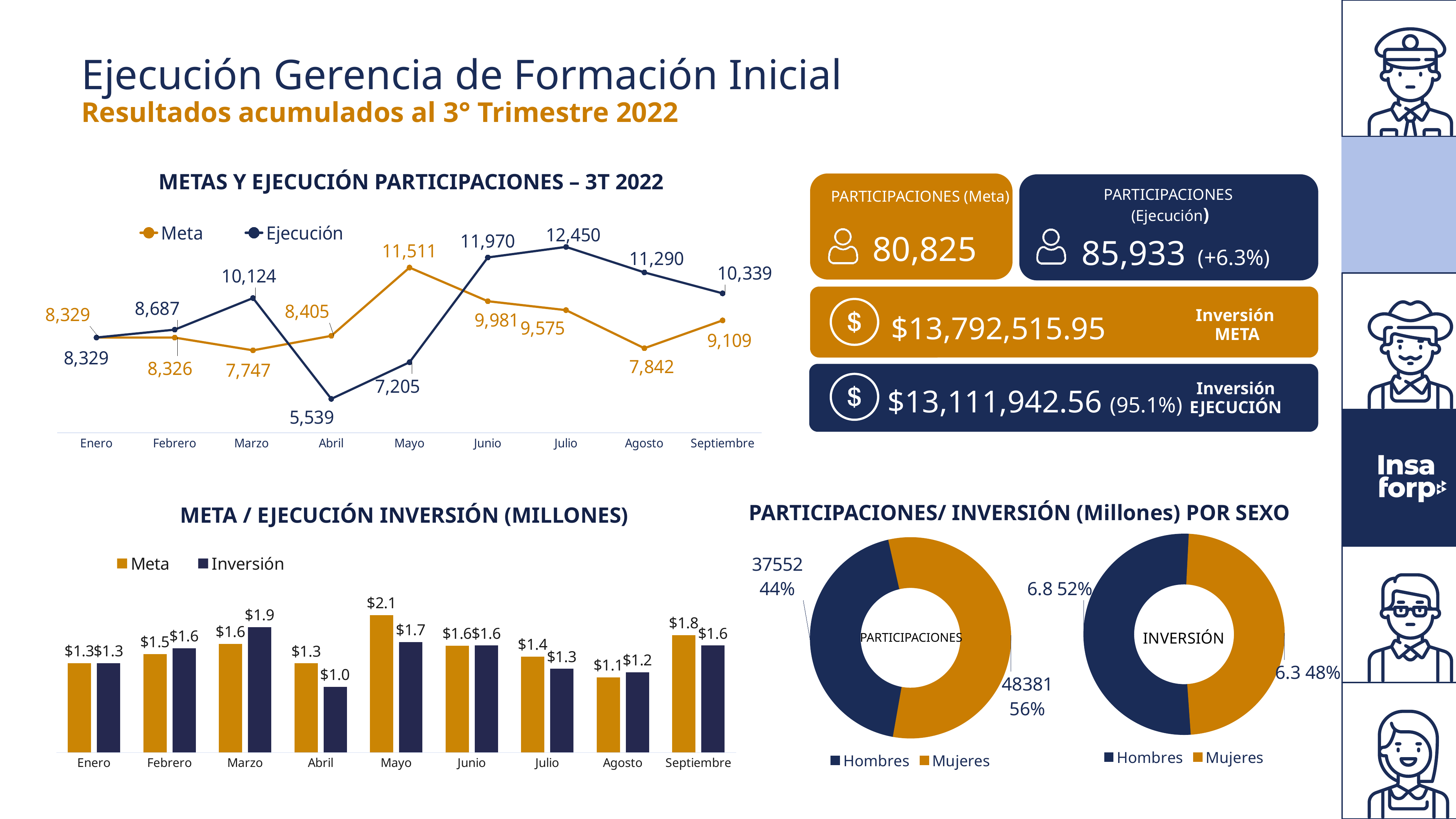
In the bar chart 'META / EJECUCIÓN INVERSIÓN (MILLONES)', which month has the highest Inversión value? Marzo In the line chart 'METAS Y EJECUCIÓN PARTICIPACIONES – 3T 2022', which month has the lowest Ejecución value? Abril In the line chart 'METAS Y EJECUCIÓN PARTICIPACIONES – 3T 2022', which series is higher in Marzo, Meta or Ejecución? Ejecución In the line chart 'METAS Y EJECUCIÓN PARTICIPACIONES – 3T 2022', which month has the highest Meta value? Mayo In the bar chart 'META / EJECUCIÓN INVERSIÓN (MILLONES)', what is the Meta value for Mayo? $2.1 In the line chart 'METAS Y EJECUCIÓN PARTICIPACIONES – 3T 2022', how many months are shown on the x axis? 9 In the line chart 'METAS Y EJECUCIÓN PARTICIPACIONES – 3T 2022', how much higher is Ejecución than Meta in Julio? 2,875 In the PARTICIPACIONES donut chart, what share of the total is Mujeres? 56% In the INVERSIÓN donut chart, what is the value shown for Hombres? 6.8 What kind of chart is 'META / EJECUCIÓN INVERSIÓN (MILLONES)'? Bar chart How many series does the legend of the bar chart 'META / EJECUCIÓN INVERSIÓN (MILLONES)' list? 2 In the line chart 'METAS Y EJECUCIÓN PARTICIPACIONES – 3T 2022', what is the Ejecución value for Julio? 12,450